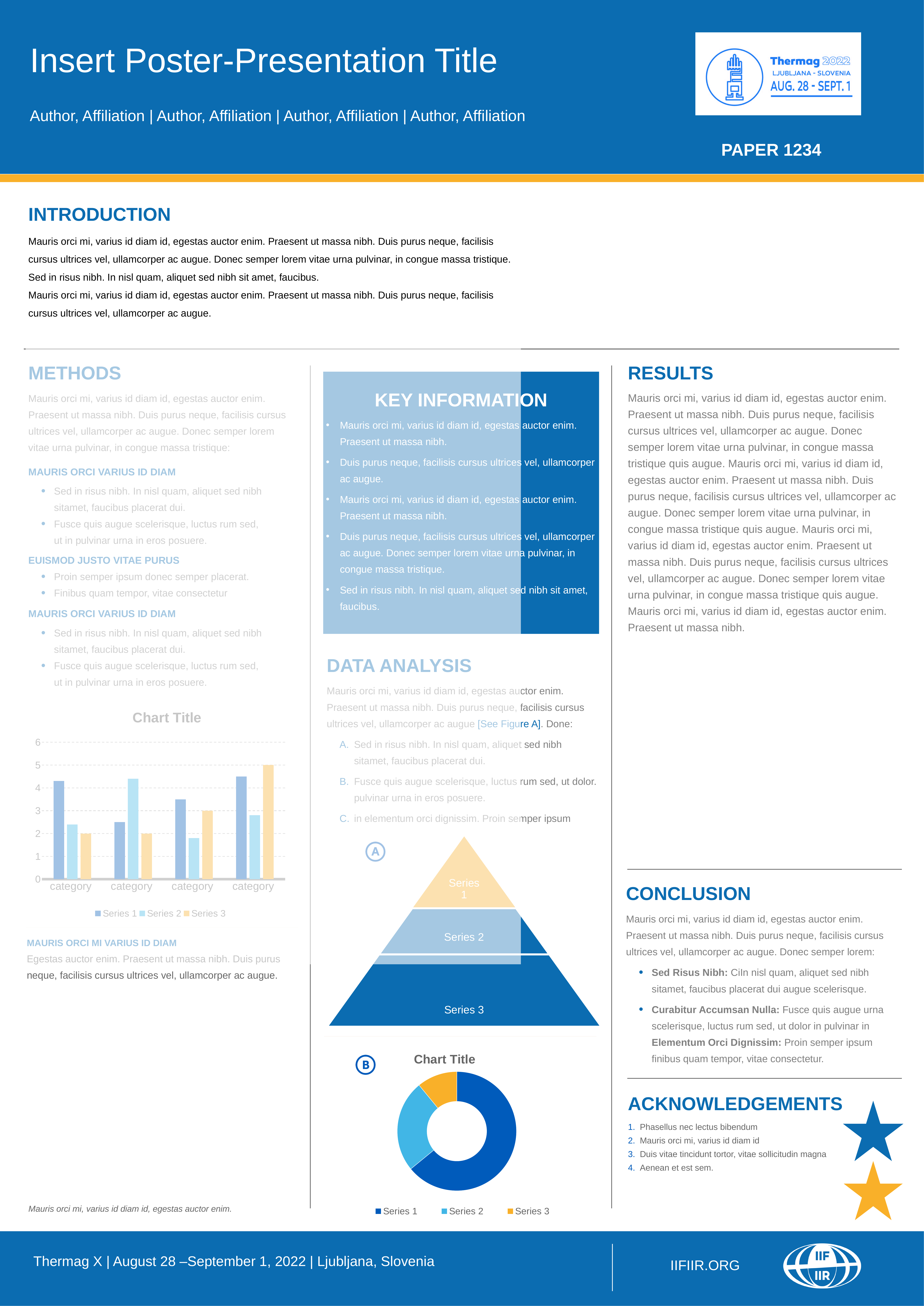
In the bar chart on the left, is the Series 3 value in the fourth (rightmost) category group greater or less than 4? greater In the bar chart on the left, is the Series 1 value in the first (leftmost) category group greater or less than 3? greater In the bar chart on the left, which series has the tallest bar in the fourth (rightmost) category group? Series 3 In the bar chart on the left, is the Series 2 value in the third category group greater or less than 3? less In the bar chart on the left, which series has the shortest bar in the third category group? Series 2 In the bar chart on the left, in the first category group, which is larger: Series 1 or Series 2? Series 1 In the bar chart on the left, how many category groups are shown on the x axis? 4 In the bar chart on the left, how many series does the legend list? 3 In the bar chart on the left, which series has the tallest bar in the second category group? Series 2 In the doughnut chart at the bottom of the middle column, which series has the largest slice? Series 1 What kind of chart is the chart at the bottom of the middle column (labelled B)? doughnut chart What kind of chart is the chart on the left under the Methods section? bar chart